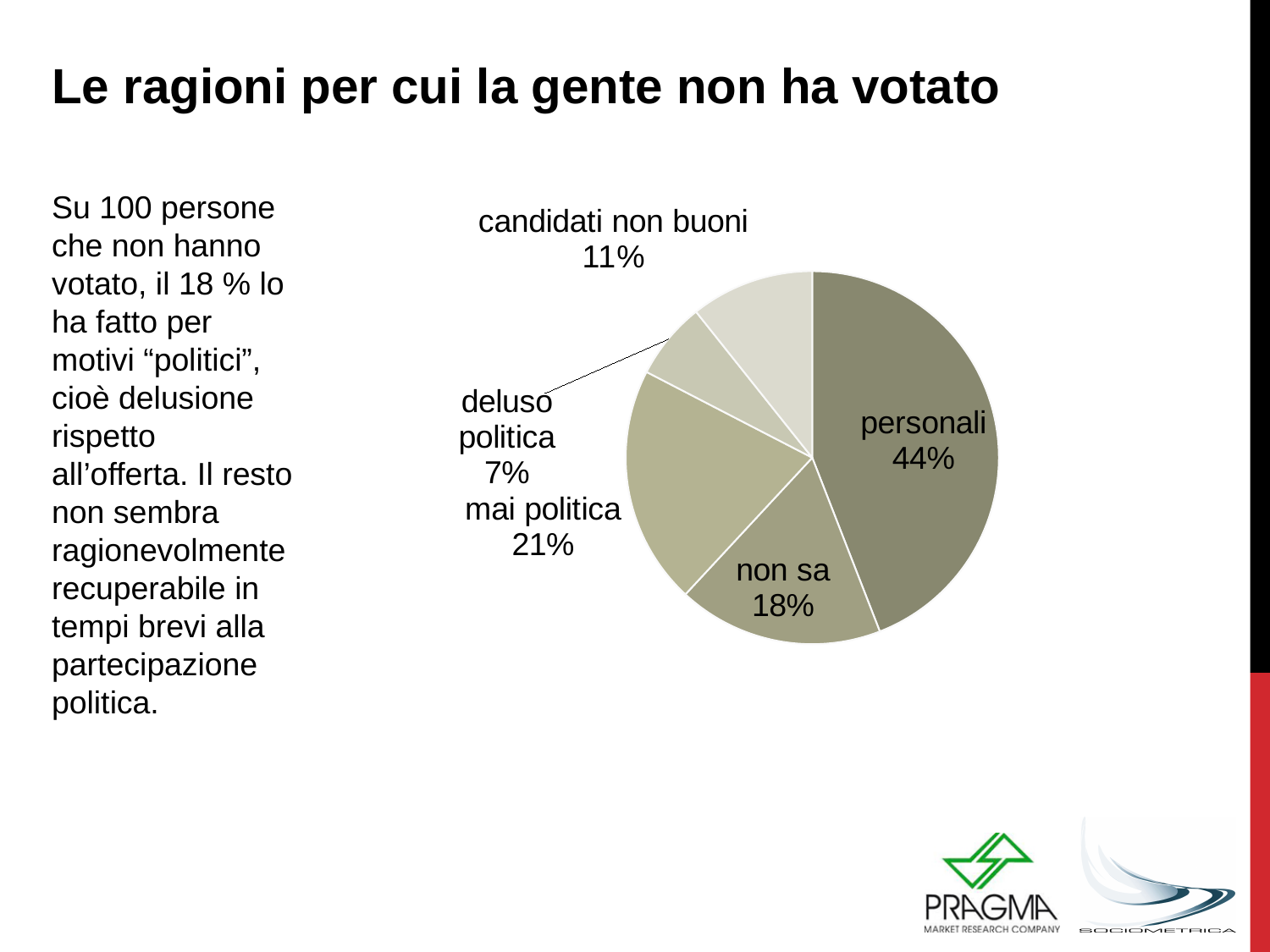
What is the difference in percentage points between 'personali' and 'mai politica'? 23 Which slice of the pie is the smallest? deluso politica What is the combined share of 'deluso politica' and 'candidati non buoni'? 18% How many slices does the pie chart have? 5 What percentage is shown for 'mai politica'? 21% What percentage is shown for 'candidati non buoni'? 11% Which slice of the pie is the largest? personali What kind of chart is shown on the slide? pie chart What percentage is shown for 'non sa'? 18% What share of the pie is labelled 'personali'? 44% Which is larger, 'non sa' or 'candidati non buoni'? non sa What percentage is shown for 'deluso politica'? 7%